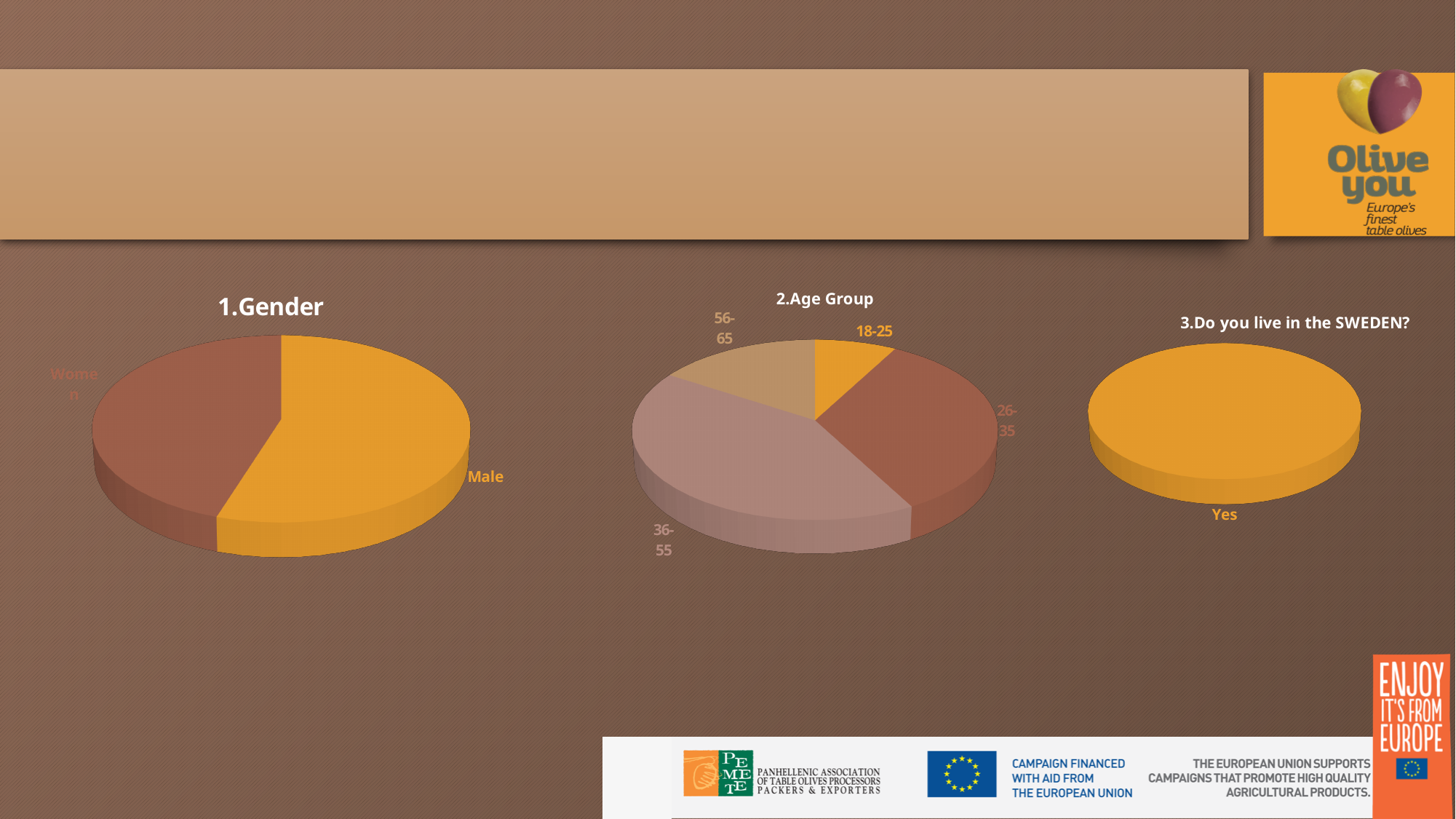
In the "3.Do you live in the SWEDEN?" chart, how many categories are shown? 1 In the "1.Gender" chart, how many categories are shown? 2 In the "2.Age Group" chart, which is larger, 36-55 or 56-65? 36-55 What kind of chart is the "2.Age Group" chart? pie chart In the "1.Gender" chart, which is larger, Male or Women? Male In the "2.Age Group" chart, how many age categories are shown? 4 In the "1.Gender" chart, what colour is the Male slice? orange What kind of chart is the "1.Gender" chart? pie chart In the "2.Age Group" chart, which age group has the largest slice? 36-55 In the "2.Age Group" chart, which is larger, 26-35 or 18-25? 26-35 In the "3.Do you live in the SWEDEN?" chart, what is the only category shown? Yes What is the title of the chart on the right of the slide? 3.Do you live in the SWEDEN?